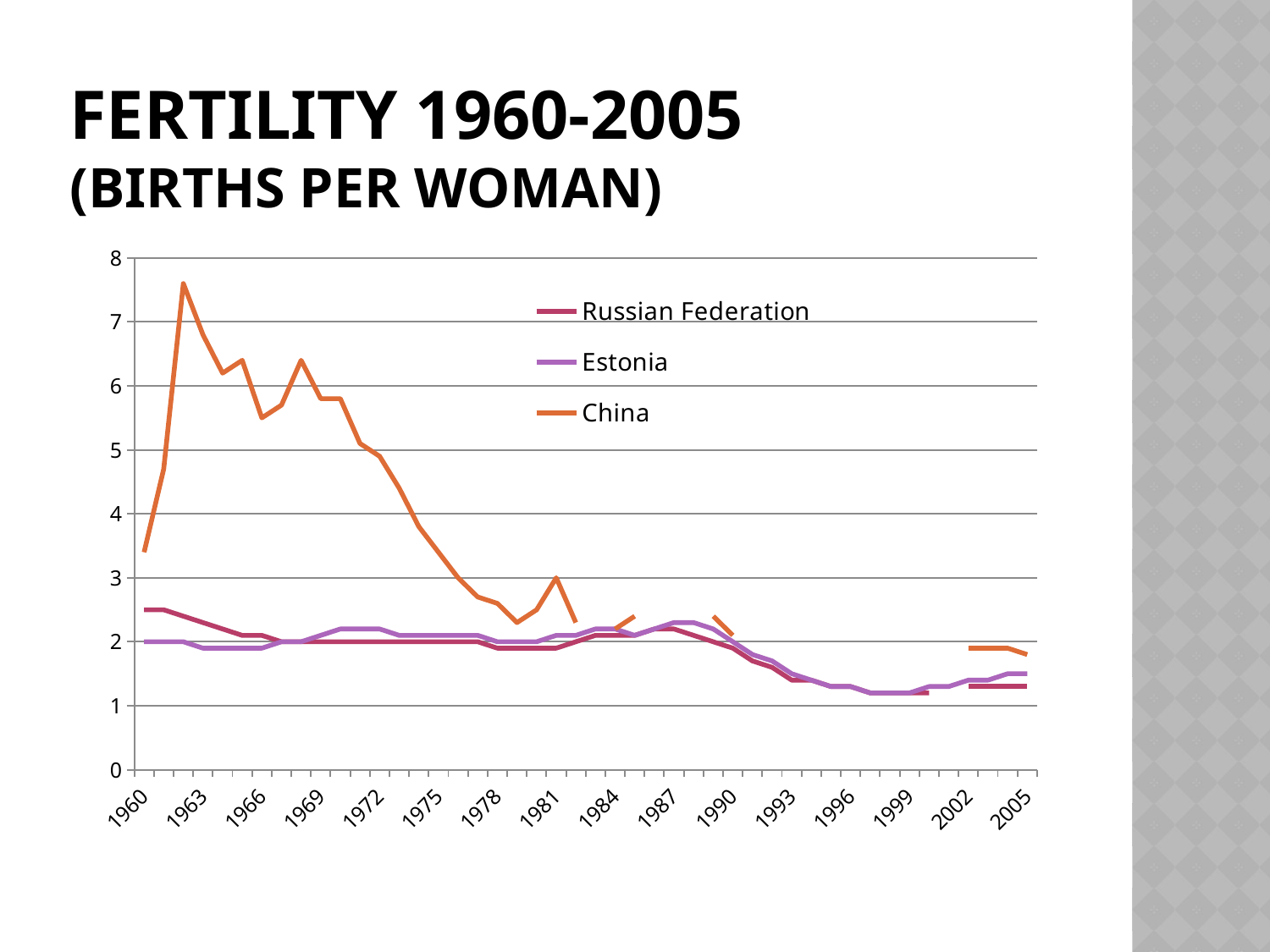
How many series does the legend list? 3 Is the value for Estonia in 1999 greater or less than 2? less Is the value for the Russian Federation in 1960 greater or less than 3? less Does the value for the Russian Federation rise or fall between 1987 and 1999? fall Which series are listed in the legend? Russian Federation, Estonia, China Which series has the highest value in 1962? China Is the value for China in 1962 greater or less than 7? greater In 1969, which is higher, China or Estonia? China Which series is drawn in orange? China What kind of chart is shown on the slide? line chart How many year labels are shown on the x axis? 16 Does the value for China rise or fall between 1962 and 1980? fall